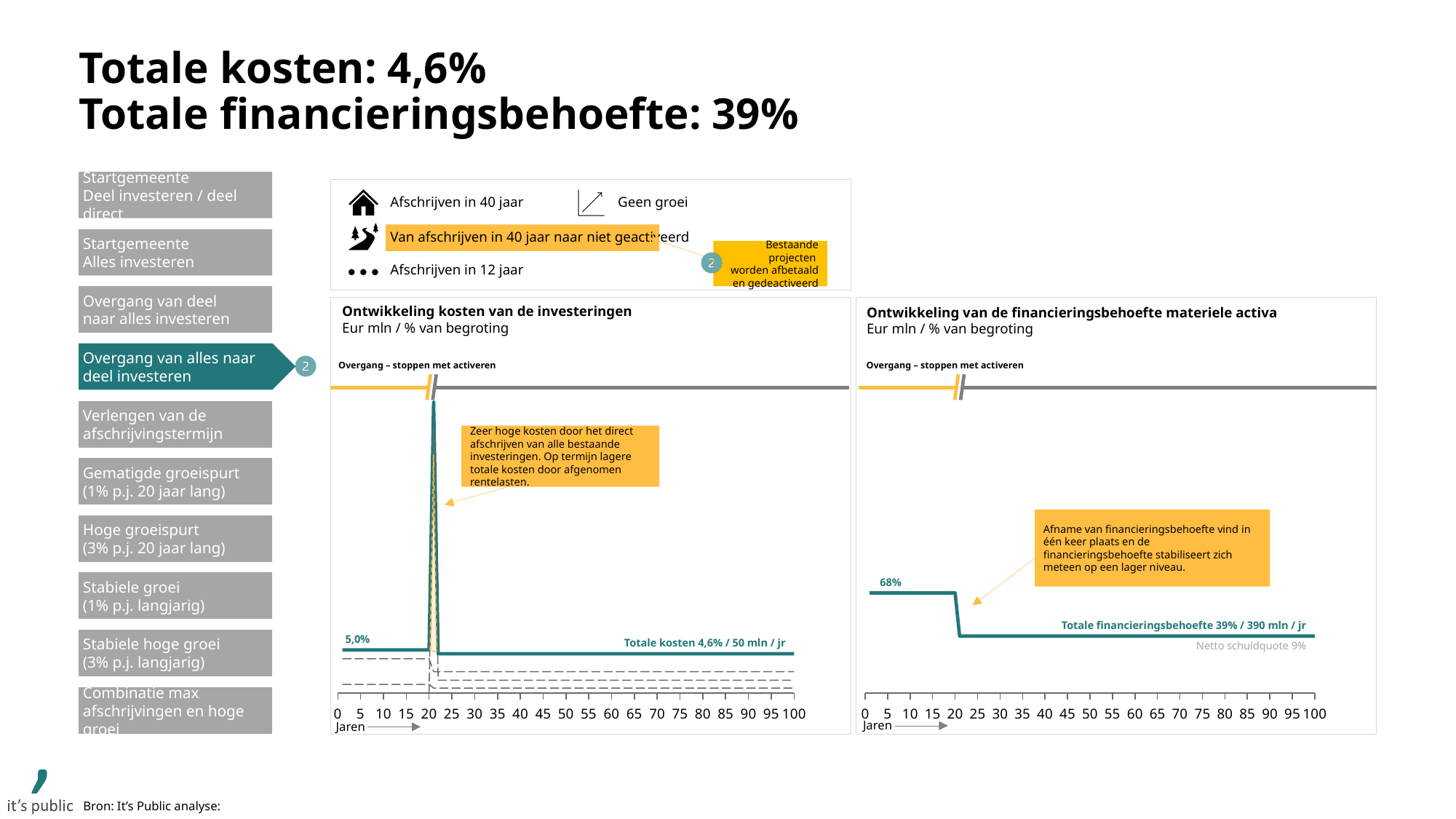
In the chart 'Ontwikkeling van de financieringsbehoefte materiele activa', by how many percentage points does the financing need fall from its starting value of 68% to its later level of 39%? 29 percentage points In the chart 'Ontwikkeling kosten van de investeringen', which is larger: the starting cost level of 5,0% or the later total cost level of 4,6%? 5,0% In the chart 'Ontwikkeling van de financieringsbehoefte materiele activa', does the line rise or fall after year 20? fall In the chart 'Ontwikkeling van de financieringsbehoefte materiele activa', what is the 'Netto schuldquote' value shown? 9% What type of chart is 'Ontwikkeling kosten van de investeringen'? line chart In the chart 'Ontwikkeling kosten van de investeringen', what are the total costs after the transition, as labelled on the line? 4,6% / 50 mln / jr What is the highest value shown on the x axis ('Jaren') of the chart 'Ontwikkeling kosten van de investeringen'? 100 In the chart 'Ontwikkeling van de financieringsbehoefte materiele activa', what is the total financing need after the transition, as labelled on the line? 39% / 390 mln / jr At which year on the x axis does the transition ('Overgang – stoppen met activeren') occur in both charts? 20 In the chart 'Ontwikkeling van de financieringsbehoefte materiele activa', what is the starting value of the line? 68% In the chart 'Ontwikkeling kosten van de investeringen', what is the starting value of the cost line before the transition? 5,0% What unit is given in the subtitle of the chart 'Ontwikkeling van de financieringsbehoefte materiele activa'? Eur mln / % van begroting